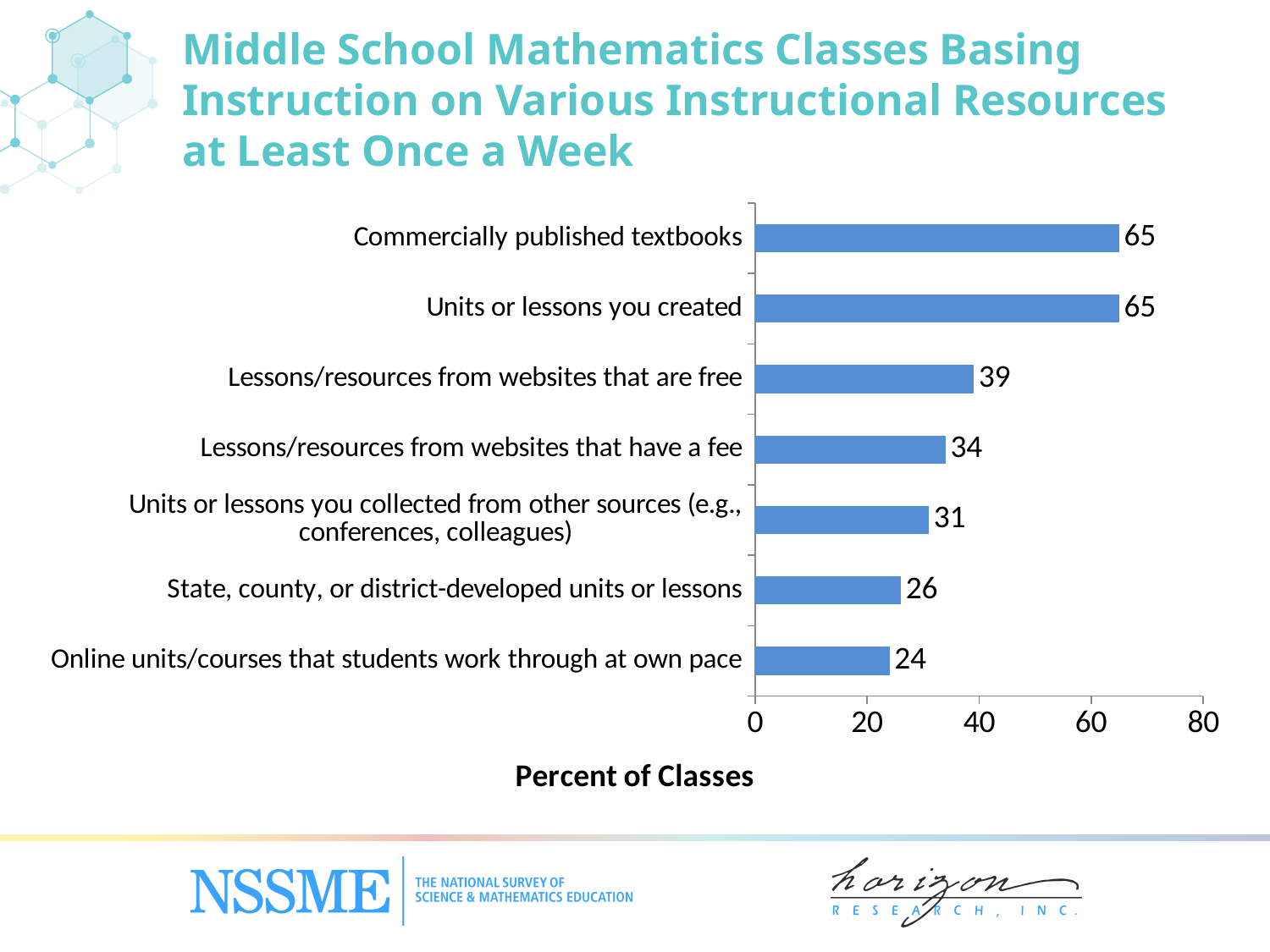
What is the value for 'Online units/courses that students work through at own pace'? 24 What is the value for 'State, county, or district-developed units or lessons'? 26 What is the label of the horizontal axis? Percent of Classes What kind of chart is shown on the slide? bar chart Which category has the lowest value? Online units/courses that students work through at own pace What is the difference between the values for 'Lessons/resources from websites that are free' and 'Lessons/resources from websites that have a fee'? 5 What is the value for 'Lessons/resources from websites that are free'? 39 What is the difference between the values for 'Commercially published textbooks' and 'Online units/courses that students work through at own pace'? 41 What percent of classes base instruction on commercially published textbooks at least once a week? 65 How many categories are shown in the chart? 7 Is the value for 'Lessons/resources from websites that have a fee' greater or less than 40? less Which is larger: the value for 'Units or lessons you collected from other sources' or 'State, county, or district-developed units or lessons'? Units or lessons you collected from other sources